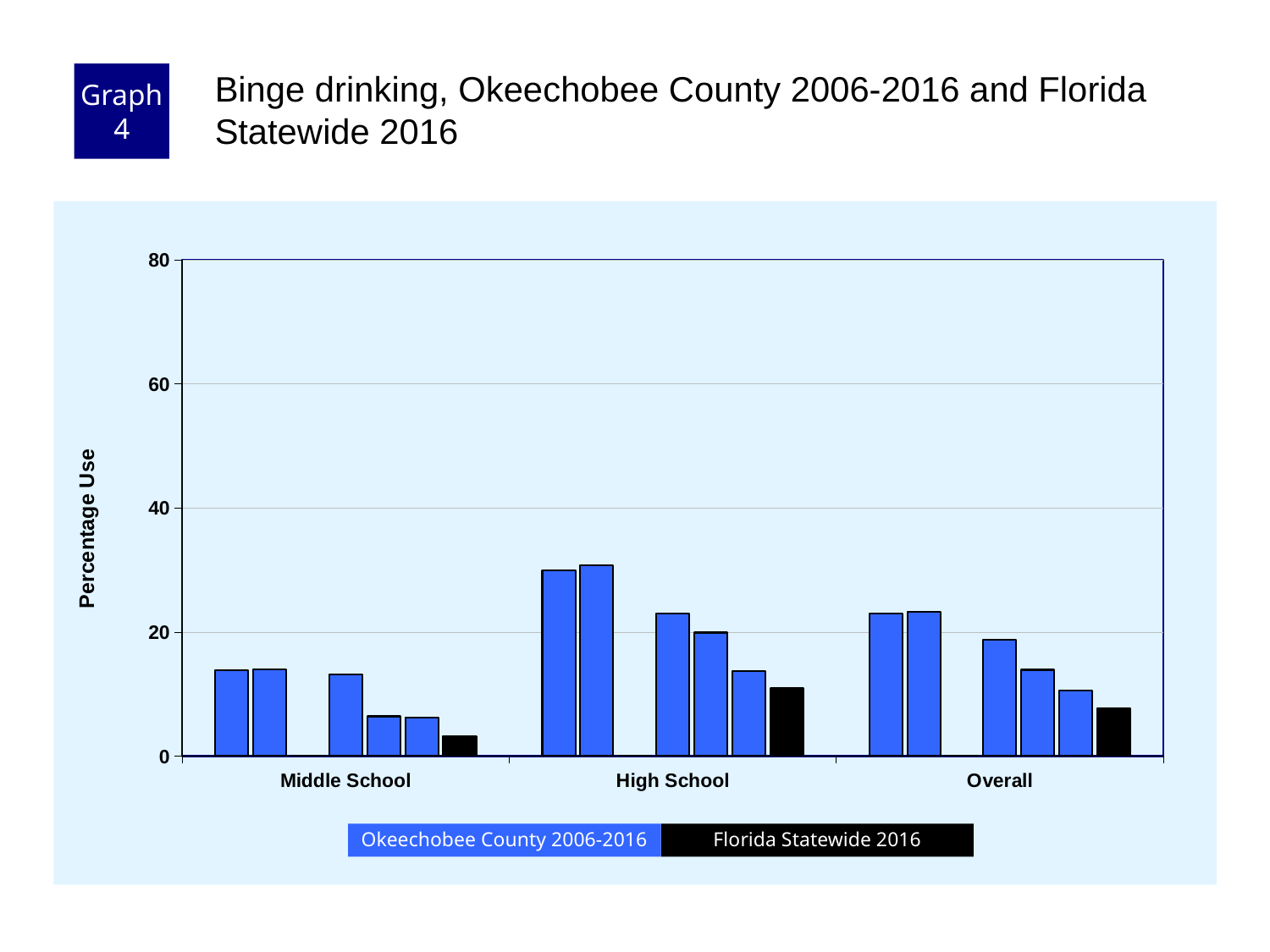
What kind of chart is shown on the slide? bar chart Is the Florida Statewide 2016 value for High School greater or less than 20? less What is the label on the y axis? Percentage Use Is the Florida Statewide 2016 value for Middle School greater or less than 20? less Which category has the lowest bars overall? Middle School Is the tallest Okeechobee County bar for High School greater or less than 20? greater What colour are the Florida Statewide 2016 bars? black Within the High School group, do the Okeechobee County bars rise or fall from left to right? fall Which category has the highest bars overall? High School Which is larger, the Florida Statewide 2016 value for High School or for Middle School? High School How many series does the legend list? 2 How many school-level categories are shown on the x axis? 3